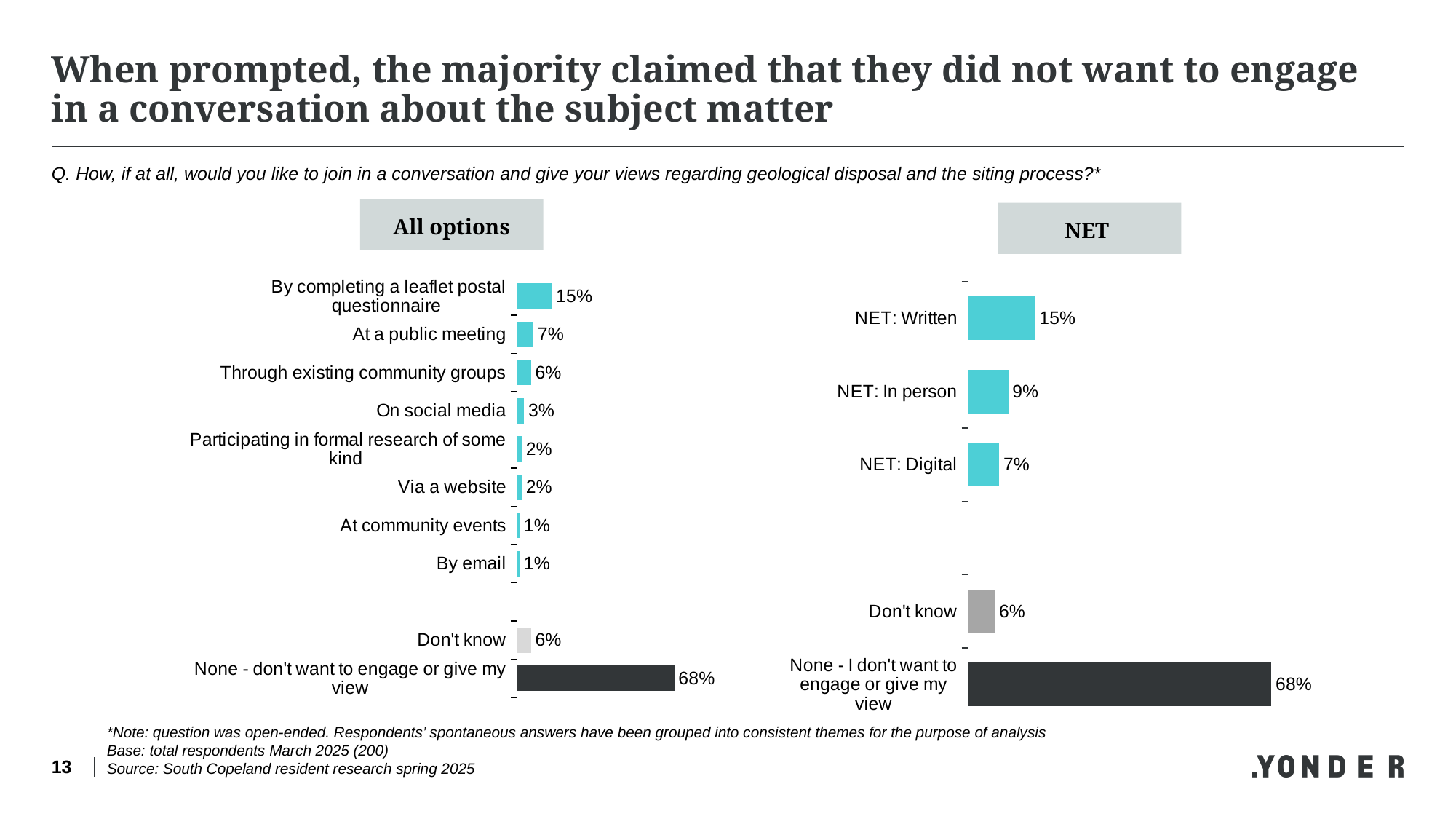
In the 'All options' chart, which is larger: 'At a public meeting' or 'Via a website'? At a public meeting In the 'NET' chart, what colour is the bar for 'Don't know'? Grey In the 'All options' chart, what is the difference between 'Through existing community groups' and 'On social media'? 3% How many categories are shown in the 'All options' chart? 10 How many categories are shown in the 'NET' chart? 5 In the 'All options' chart, what percentage chose 'At a public meeting'? 7% What type of chart is the 'NET' chart? Bar chart In the 'NET' chart, what is the value for 'NET: Digital'? 7% In the 'All options' chart, which category has the highest value? None - don't want to engage or give my view In the 'All options' chart, what percentage chose 'By completing a leaflet postal questionnaire'? 15% In the 'NET' chart, what is the difference between 'NET: Written' and 'NET: Digital'? 8% In the 'NET' chart, what is the value for 'NET: In person'? 9%